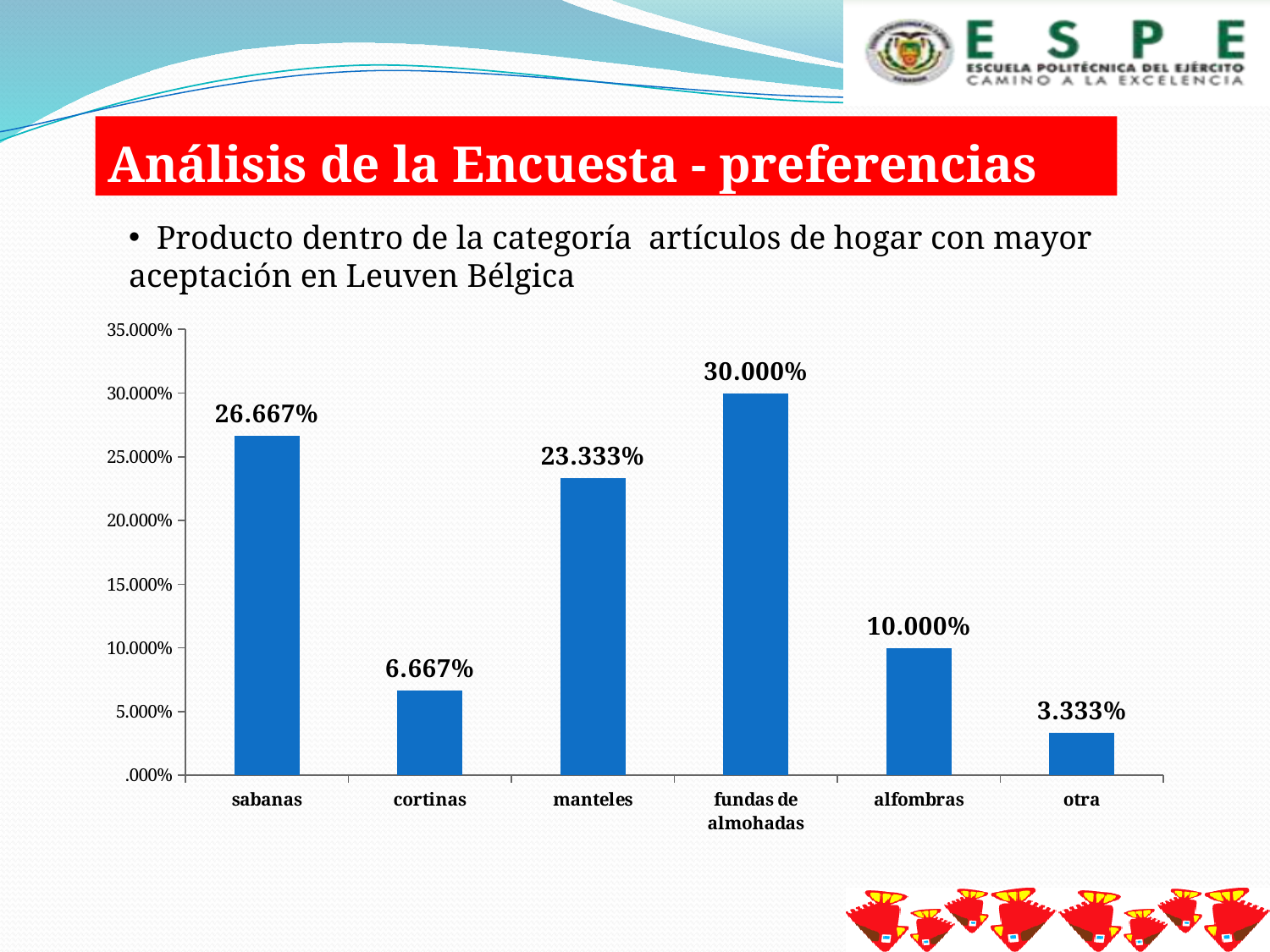
Which category has the highest value? fundas de almohadas What is the value for fundas de almohadas? 30.000% What is the difference between the values for sabanas and cortinas? 20.000% What kind of chart is shown on the slide? bar chart What is the value for alfombras? 10.000% What is the value for sabanas? 26.667% How many categories are shown on the x axis? 6 What is the difference between the values for fundas de almohadas and manteles? 6.667% Which is larger, the value for manteles or the value for alfombras? manteles What is the value for otra? 3.333% Which category has the lowest value? otra Is the value for cortinas greater or less than 10.000%? less